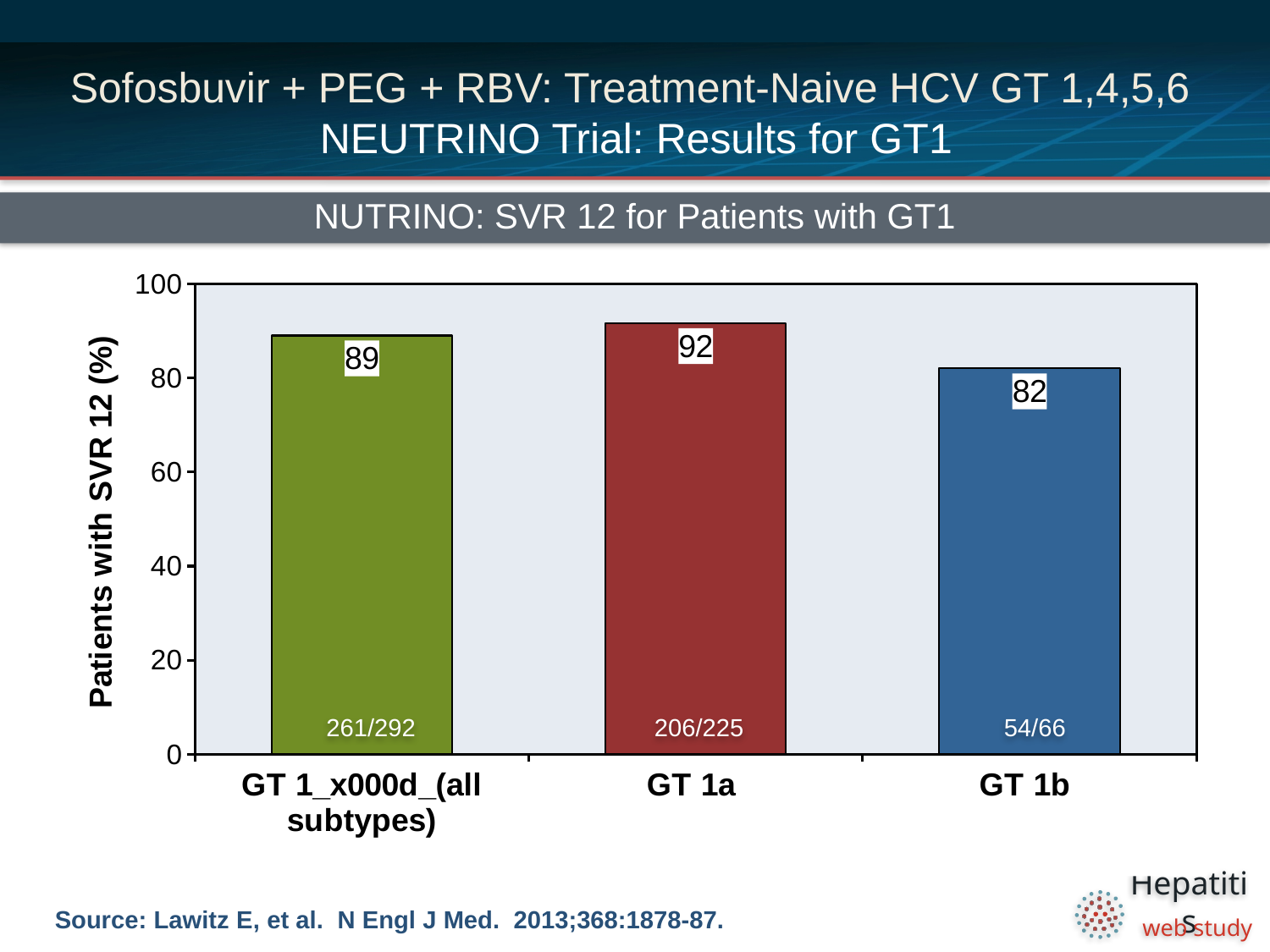
What fraction of patients is printed inside the GT 1a bar? 206/225 What is the label of the y axis? Patients with SVR 12 (%) Which has a higher SVR 12 value, GT 1 (all subtypes) or GT 1b? GT 1 (all subtypes) What is the SVR 12 value for GT 1a? 92 What is the SVR 12 value for GT 1b? 82 What kind of chart is shown on the slide? Bar chart What is the SVR 12 value for GT 1 (all subtypes)? 89 Which category has the lowest SVR 12 value? GT 1b Which category has the highest SVR 12 value? GT 1a What is the difference between the SVR 12 values for GT 1a and GT 1b? 10 What fraction of patients is printed inside the GT 1b bar? 54/66 How many categories are shown on the x axis? 3